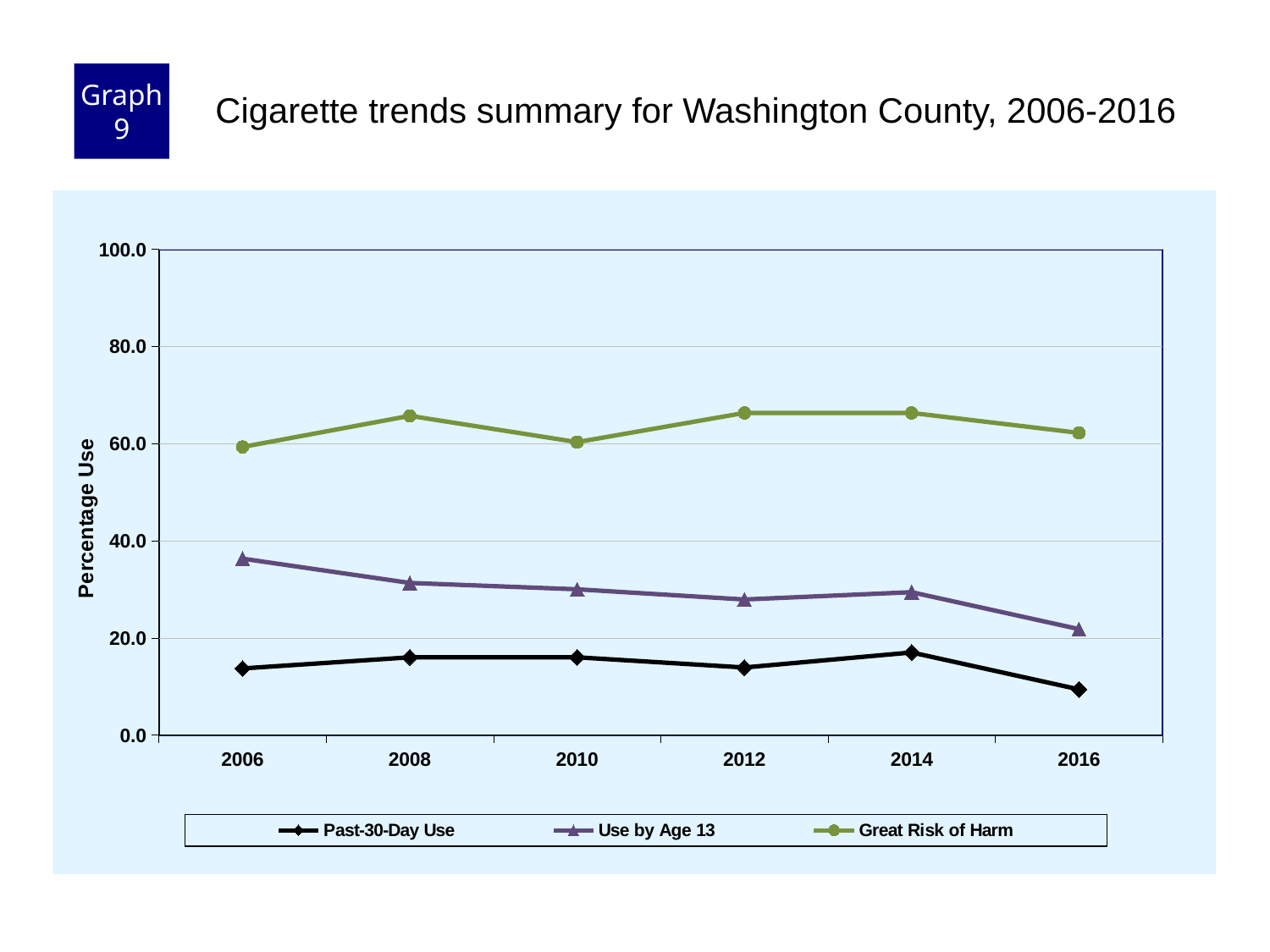
Is the value for Past-30-Day Use in 2016 greater or less than 20.0? less What kind of chart is shown on the slide? Line chart How many years are plotted along the x axis? 6 In 2016, which series has the higher value: Great Risk of Harm or Use by Age 13? Great Risk of Harm Is the value for Great Risk of Harm in 2008 greater or less than 60.0? greater Does Use by Age 13 generally rise or fall from 2006 to 2016? fall Is the value for Use by Age 13 in 2006 greater or less than 40.0? less In which year is Use by Age 13 highest? 2006 What is the title of the y axis? Percentage Use For Past-30-Day Use, which year has the higher value: 2014 or 2016? 2014 In which year is Past-30-Day Use lowest? 2016 How many series does the legend list? 3